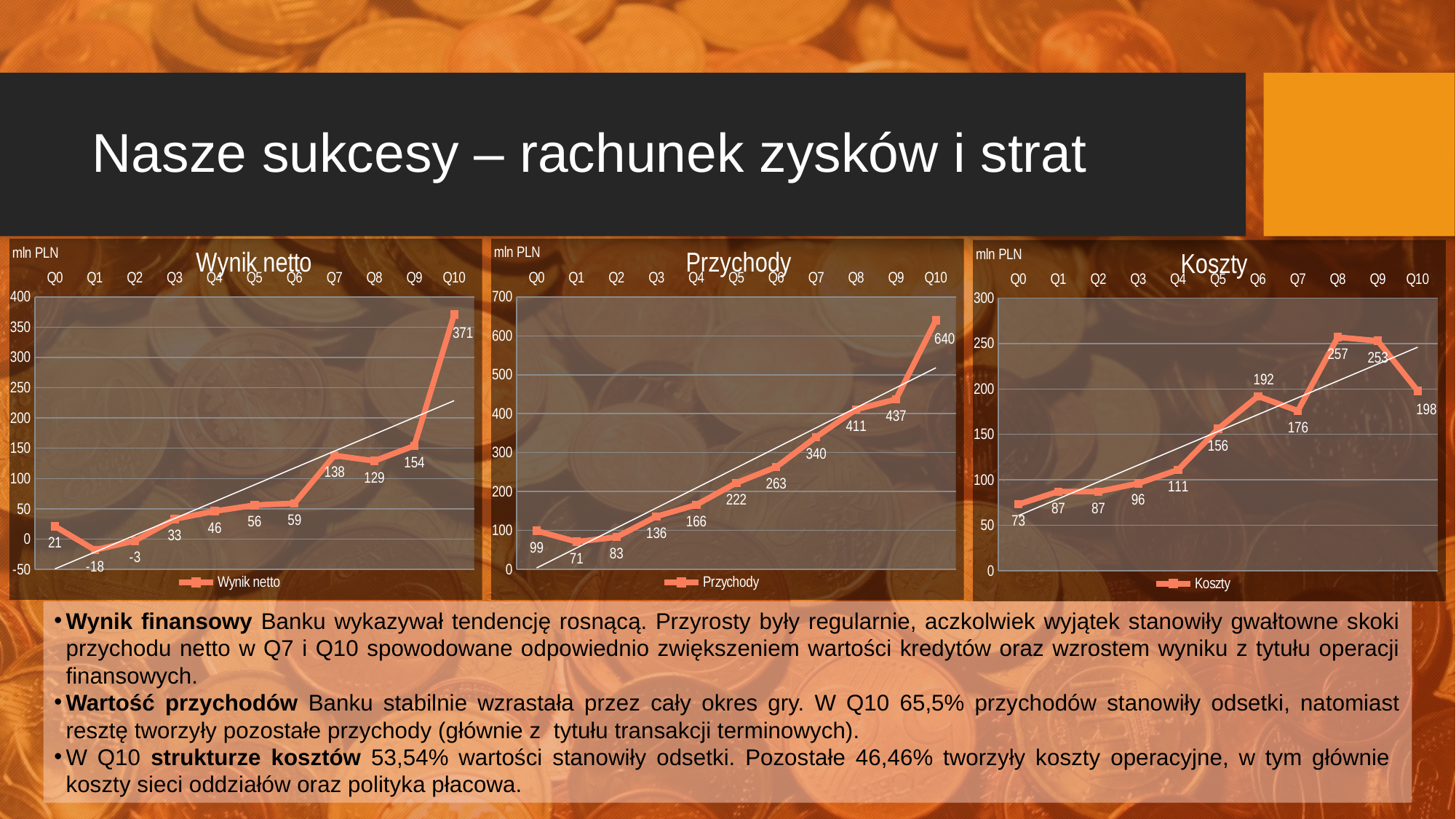
What unit is shown in the top-left corner of each chart? mln PLN In the 'Koszty' chart, what is the value for Q8? 257 How many quarters are plotted in the 'Przychody' chart? 11 In the 'Przychody' chart, which quarter has the highest value? Q10 In the 'Koszty' chart, which is larger, the value for Q7 or the value for Q9? Q9 In the 'Wynik netto' chart, what is the difference between the values for Q7 and Q8? 9 In the 'Przychody' chart, what is the difference between the values for Q10 and Q9? 203 In the 'Koszty' chart, which quarter has the lowest value? Q0 What type of chart is the 'Koszty' chart? Line chart In the 'Wynik netto' chart, what is the value for Q10? 371 In the 'Przychody' chart, what is the value for Q6? 263 In the 'Wynik netto' chart, which quarter has the lowest value? Q1